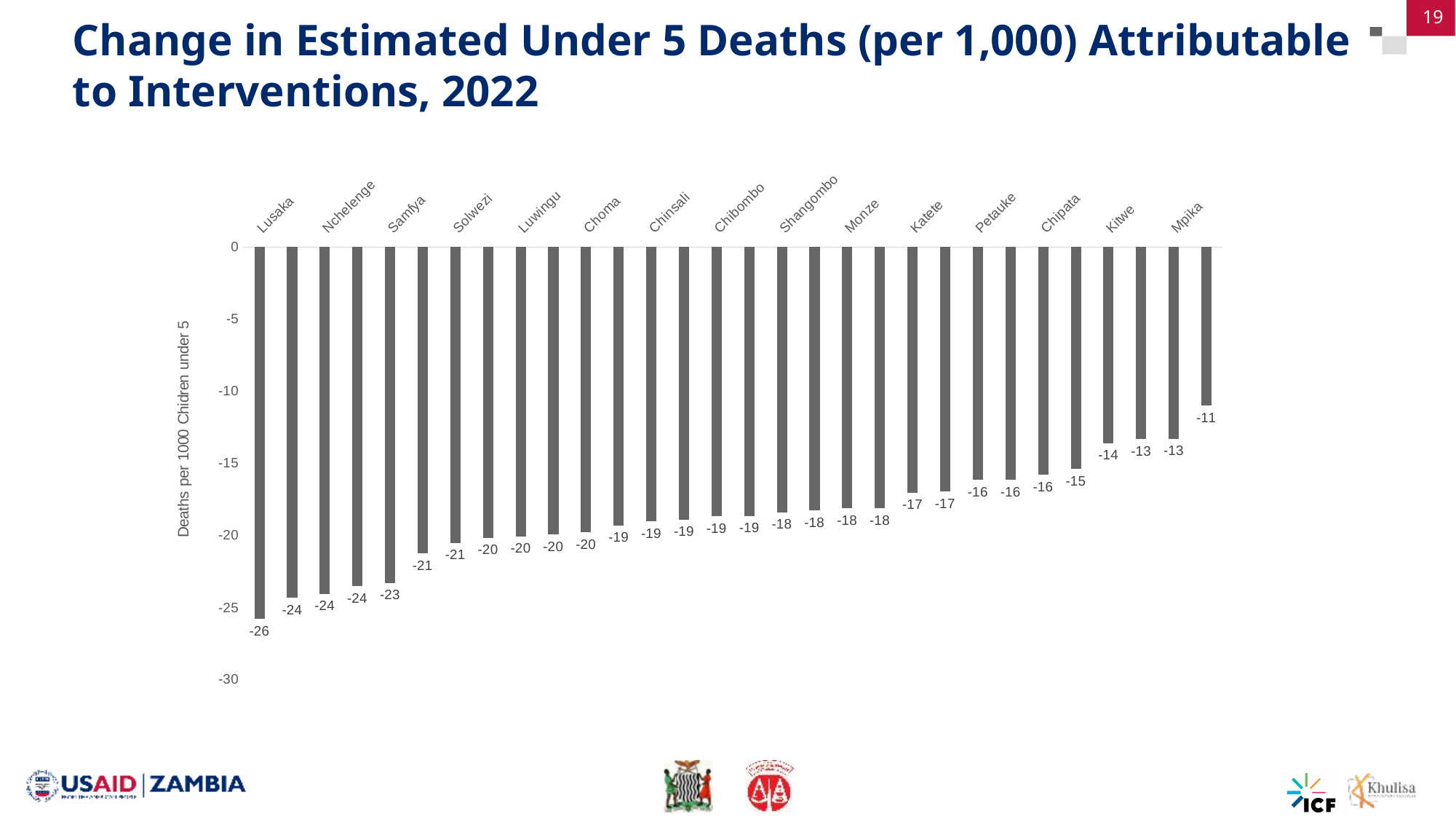
How many bars are plotted in the chart? 30 What is the value for Mpika? -13 What is the value for Samfya? -23 What is the difference between the values for Lusaka and Mpika? 13 What kind of chart is shown? bar chart Which has the larger reduction in deaths, Lusaka or Samfya? Lusaka Is the value for Lusaka greater or less than -25? less What is the title of the vertical axis? Deaths per 1000 Chidren under 5 What is the value for Kitwe? -14 What is the value for Katete? -17 What is the value for Lusaka? -26 Which labeled district has the lowest (most negative) value? Lusaka